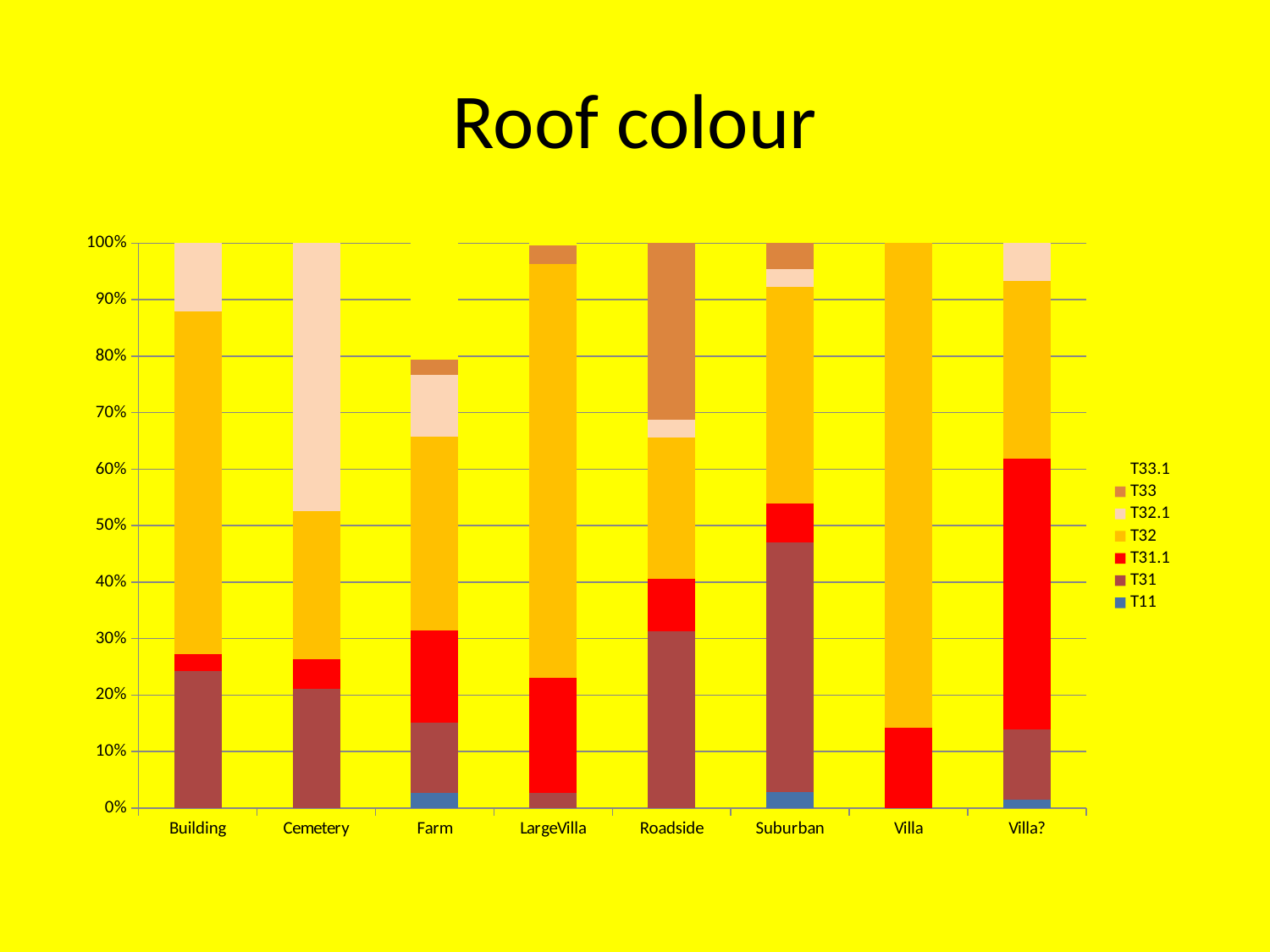
How many series does the legend list? 7 How many categories are shown along the x axis? 8 Which category's bar is made up of only two segments? Villa Is the top of the T32 segment for Building greater or less than 80%? greater Is the top of the T32 segment for Cemetery greater or less than 60%? less Is the top of the T31.1 segment for Villa? greater or less than 50%? greater What kind of chart is shown on the slide? Stacked bar chart What is the title of the chart? Roof colour Which category has the largest T32.1 segment? Cemetery Which category has the largest T31.1 segment? Villa?